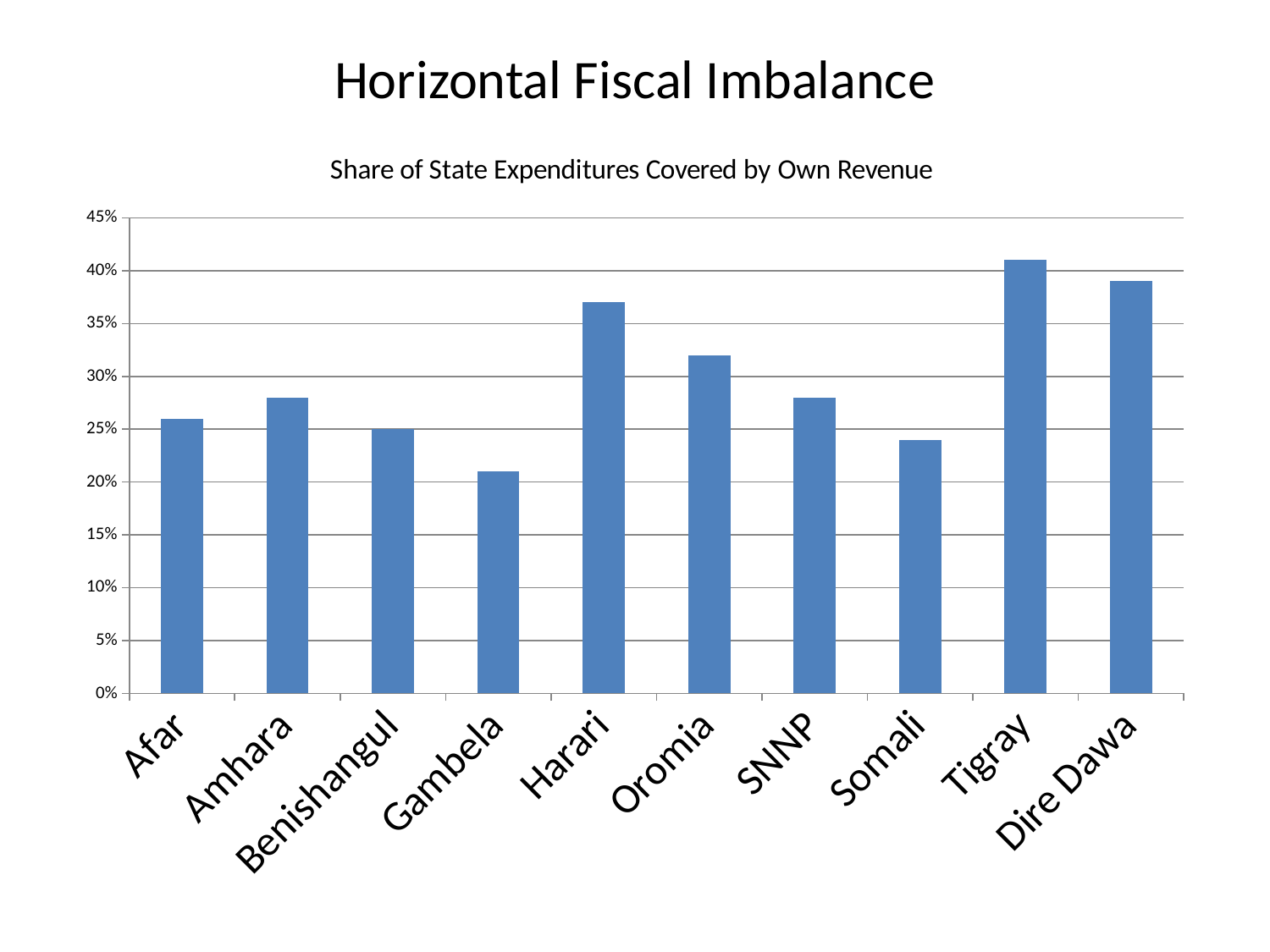
Which state has the lowest share of state expenditures covered by own revenue? Gambela What kind of chart is shown on the slide? bar chart Is the value for Gambela greater or less than 25%? less Is the value for Dire Dawa greater or less than 40%? less What is the share of state expenditures covered by own revenue for Benishangul? 25% Which has a larger share of expenditures covered by own revenue, Oromia or SNNP? Oromia How many states are shown on the x axis of the chart? 10 Which state has the highest share of state expenditures covered by own revenue? Tigray Is the value for Harari greater or less than 35%? greater Which has a larger share of expenditures covered by own revenue, Harari or Oromia? Harari What is the title of the chart below the slide heading? Share of State Expenditures Covered by Own Revenue